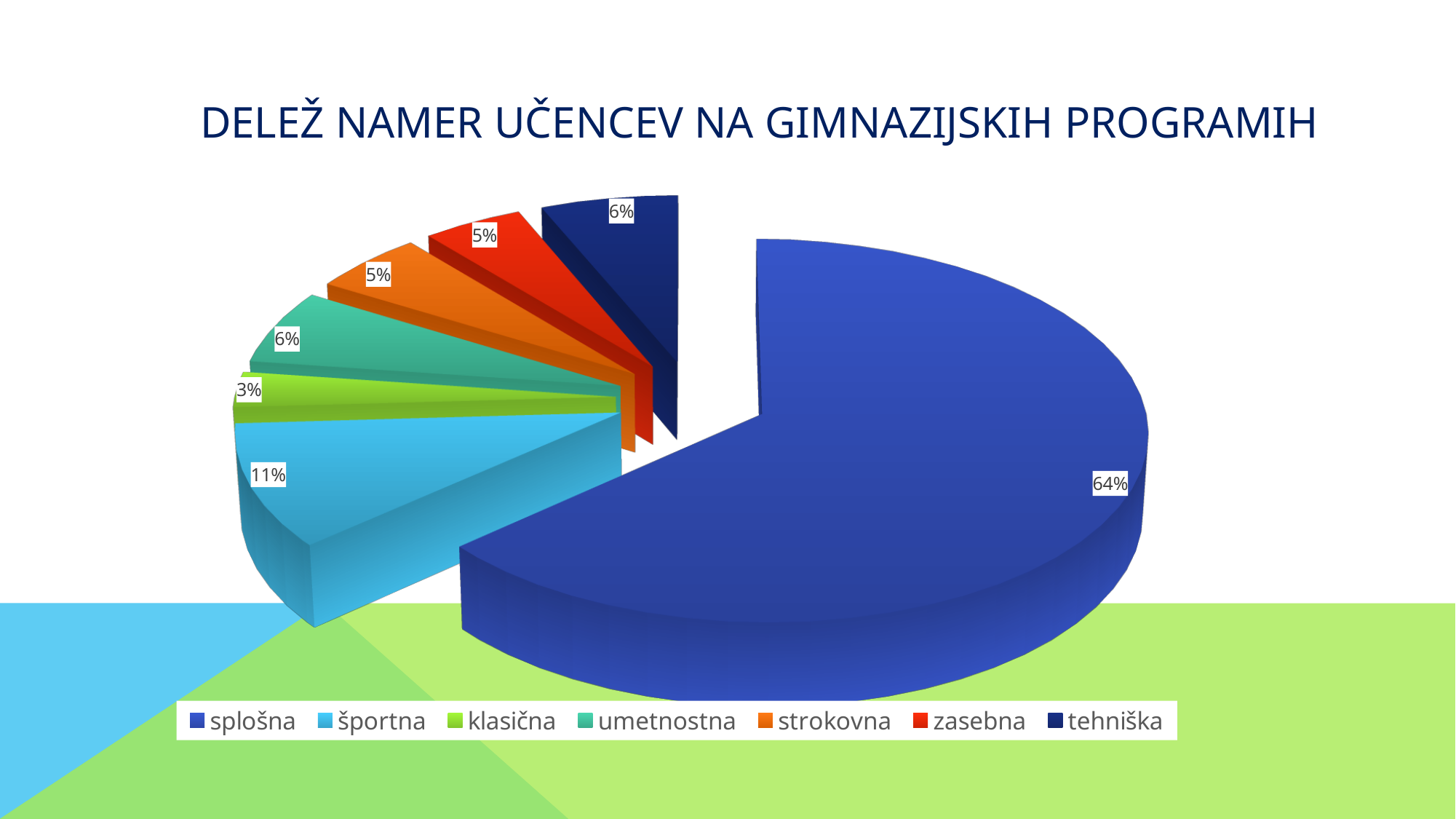
What type of chart is shown on the slide? pie chart What share of the pie does strokovna have? 5% What is the title of the chart? DELEŽ NAMER UČENCEV NA GIMNAZIJSKIH PROGRAMIH Which is larger, the share for športna or the share for tehniška? športna What is the difference in percentage points between splošna and športna? 53 How many categories does the legend list? 7 What share of the pie does splošna have? 64% What share of the pie does umetnostna have? 6% Which category has the largest slice of the pie? splošna What share of the pie does športna have? 11% Which category has the smallest slice of the pie? klasična What share of the pie does klasična have? 3%